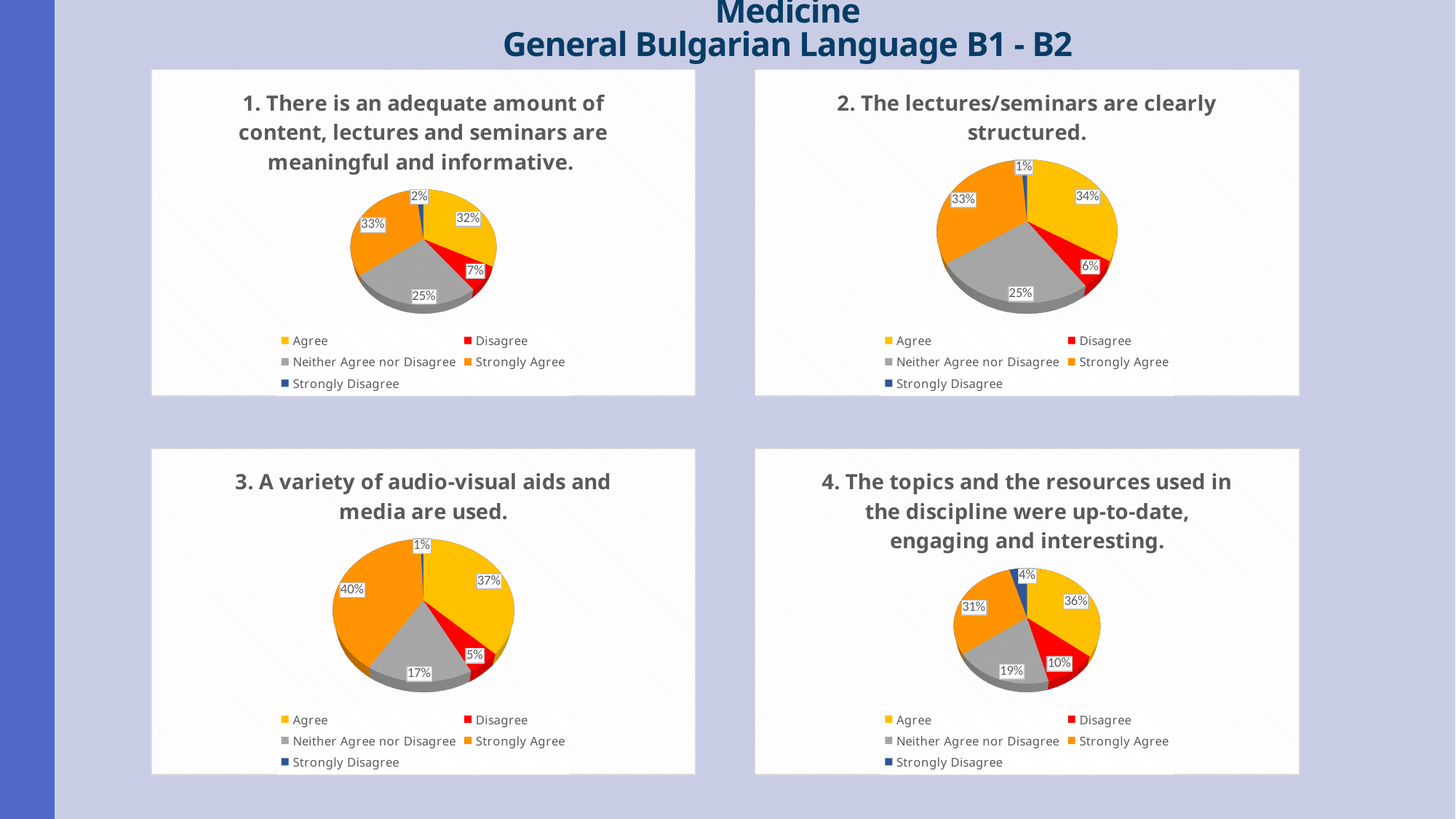
In the chart titled "1. There is an adequate amount of content, lectures and seminars are meaningful and informative.", what share of responses is Disagree? 7% In the chart titled "4. The topics and the resources used in the discipline were up-to-date, engaging and interesting.", which is larger, Agree or Strongly Agree? Agree In the chart titled "4. The topics and the resources used in the discipline were up-to-date, engaging and interesting.", what is the share for Strongly Disagree? 4% In the chart titled "2. The lectures/seminars are clearly structured.", which response category has the smallest share? Strongly Disagree What type of chart is used in the chart titled "3. A variety of audio-visual aids and media are used."? Pie chart In the chart titled "1. There is an adequate amount of content, lectures and seminars are meaningful and informative.", what share of responses is Strongly Agree? 33% How many response categories does the legend list in the chart titled "1. There is an adequate amount of content, lectures and seminars are meaningful and informative."? 5 In the chart titled "2. The lectures/seminars are clearly structured.", which response category has the largest share? Agree In the chart titled "2. The lectures/seminars are clearly structured.", what is the share for Neither Agree nor Disagree? 25% In the chart titled "3. A variety of audio-visual aids and media are used.", what is the difference in percentage points between Agree and Neither Agree nor Disagree? 20 In the chart titled "4. The topics and the resources used in the discipline were up-to-date, engaging and interesting.", what is the share for Disagree? 10% In the chart titled "3. A variety of audio-visual aids and media are used.", what is the share for Strongly Agree? 40%